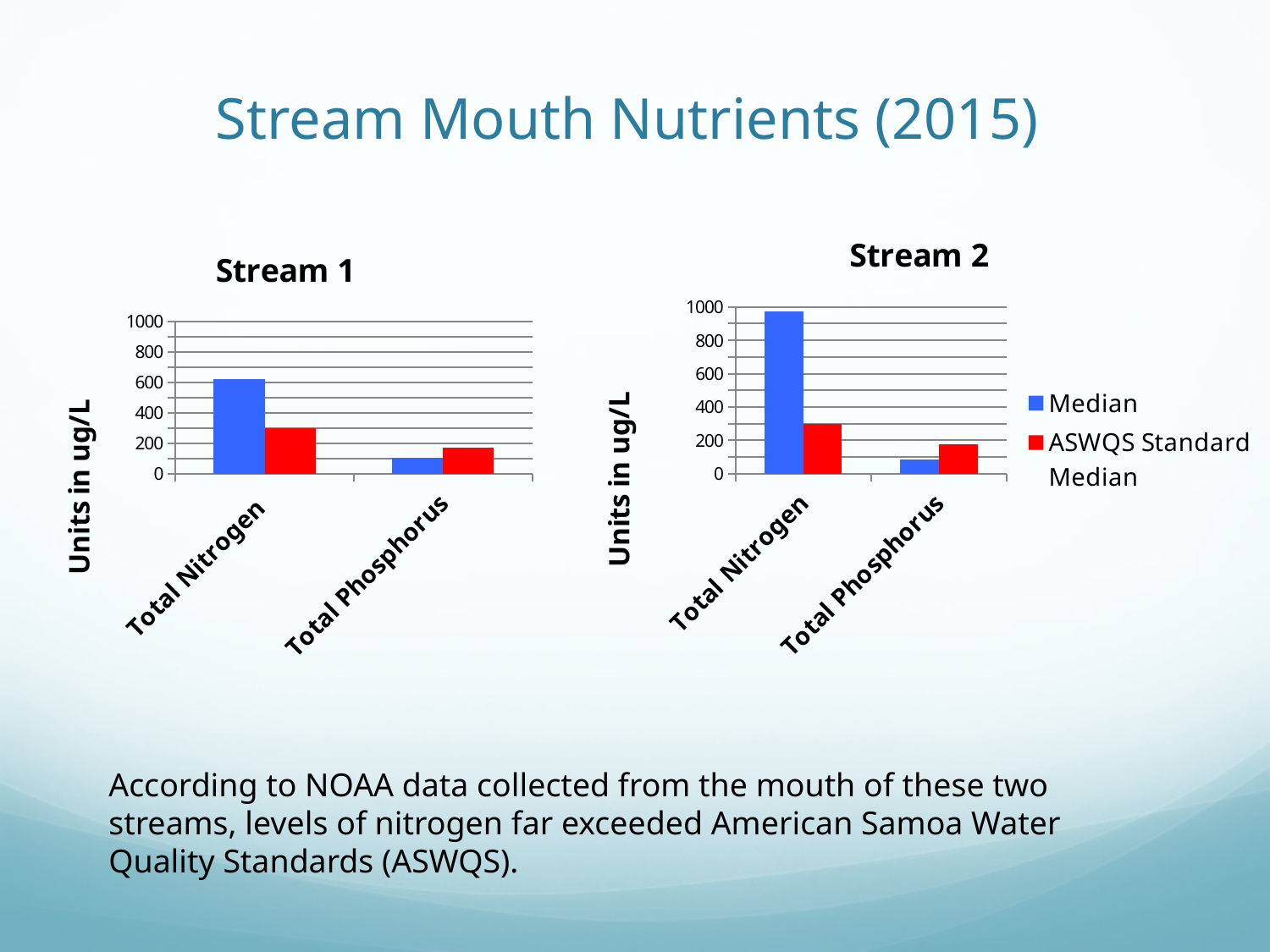
In the Stream 2 chart, which category has the highest Median value? Total Nitrogen In the Stream 2 chart, is the Median value for Total Nitrogen greater or less than 800? greater In the Stream 2 chart, which is larger for Total Phosphorus: the Median or the ASWQS Standard Median? ASWQS Standard Median In the Stream 1 chart, is the Median value for Total Nitrogen greater or less than 400? greater How many categories are shown on the x axis of the Stream 2 chart? 2 In the Stream 1 chart, which is larger for Total Nitrogen: the Median or the ASWQS Standard Median? Median How many series does the legend on the slide list? 2 What kind of chart is the Stream 1 chart? bar chart In the Stream 2 chart, is the ASWQS Standard Median value for Total Nitrogen greater or less than 400? less What is the y-axis label on the Stream 1 chart? Units in ug/L In the Stream 1 chart, which category has the lowest Median value? Total Phosphorus